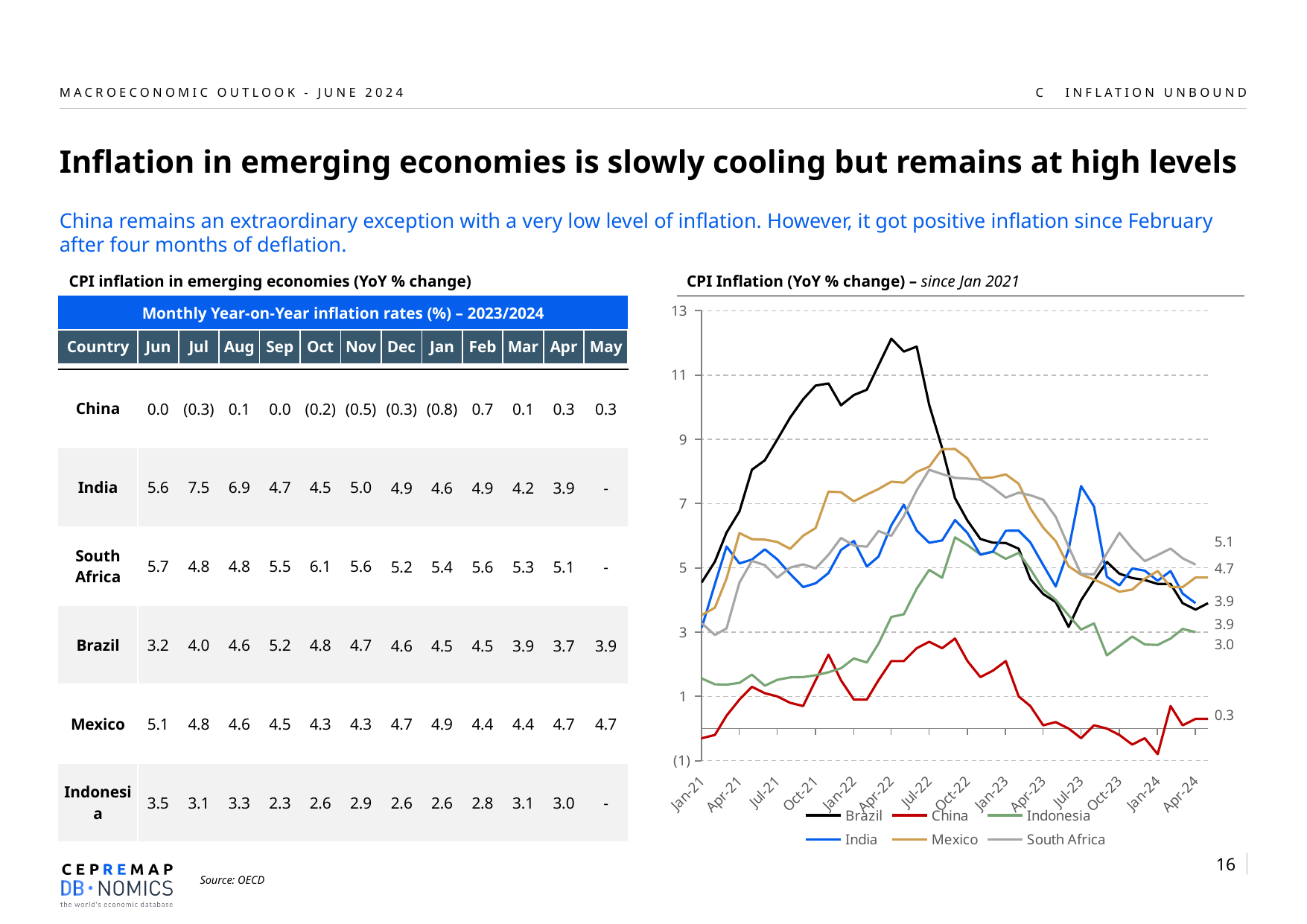
In the CPI Inflation chart, which country has the lowest inflation line at the end of the period (Apr-24)? China In the CPI Inflation chart, is China's value in Jan-24 greater or less than 1? less In the CPI Inflation chart, what is the latest labelled value for South Africa? 5.1 In the CPI Inflation chart, does Brazil's inflation rise or fall from Apr-22 to Apr-24? fall In the CPI Inflation chart, which country has the highest inflation line at the end of the period (Apr-24)? South Africa What kind of chart is the 'CPI Inflation (YoY % change) – since Jan 2021' chart? line chart How many series does the legend of the CPI Inflation chart list? 6 In the CPI Inflation chart, is Brazil's peak value around Apr-22 greater or less than 11? greater In the CPI Inflation chart, what is the latest labelled value for Indonesia? 3.0 In the CPI Inflation chart, which is larger around Apr-22: Brazil's inflation or China's inflation? Brazil In the CPI Inflation chart, what is the latest labelled value for China? 0.3 In the CPI Inflation chart, which colour is used for the China line? red